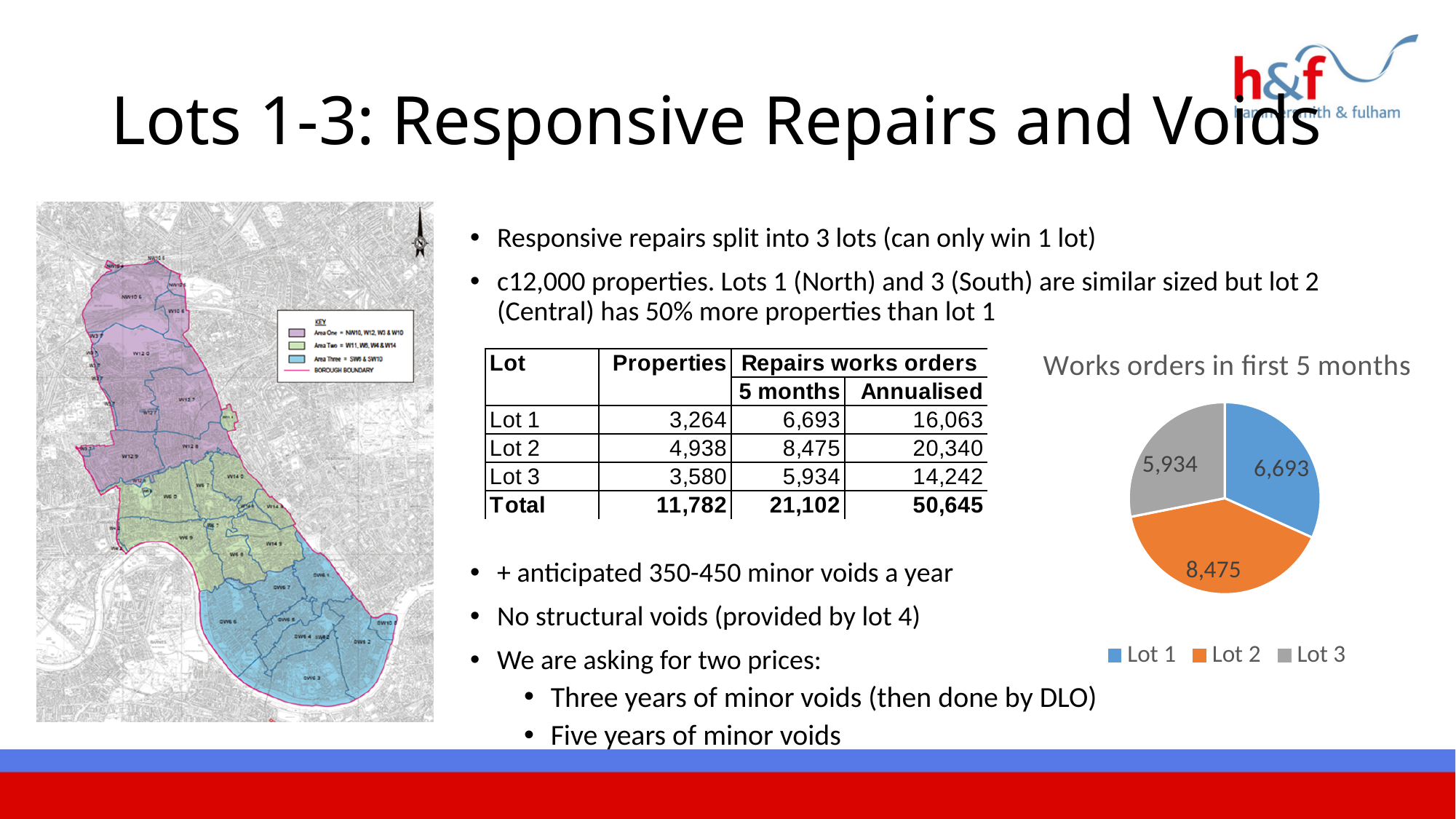
In the pie chart, what is the value for Lot 1? 6,693 Which lot has the largest slice in the pie chart? Lot 2 In the pie chart, what is the difference between the values for Lot 1 and Lot 3? 759 Which lot has the smallest slice in the pie chart? Lot 3 In the pie chart, what is the value for Lot 2? 8,475 How many slices does the pie chart have? 3 In the pie chart, what is the difference between the values for Lot 2 and Lot 1? 1,782 What kind of chart is shown on the slide? Pie chart In the pie chart, which is larger, the value for Lot 1 or the value for Lot 3? Lot 1 In the pie chart, what is the value for Lot 3? 5,934 What is the title of the pie chart? Works orders in first 5 months